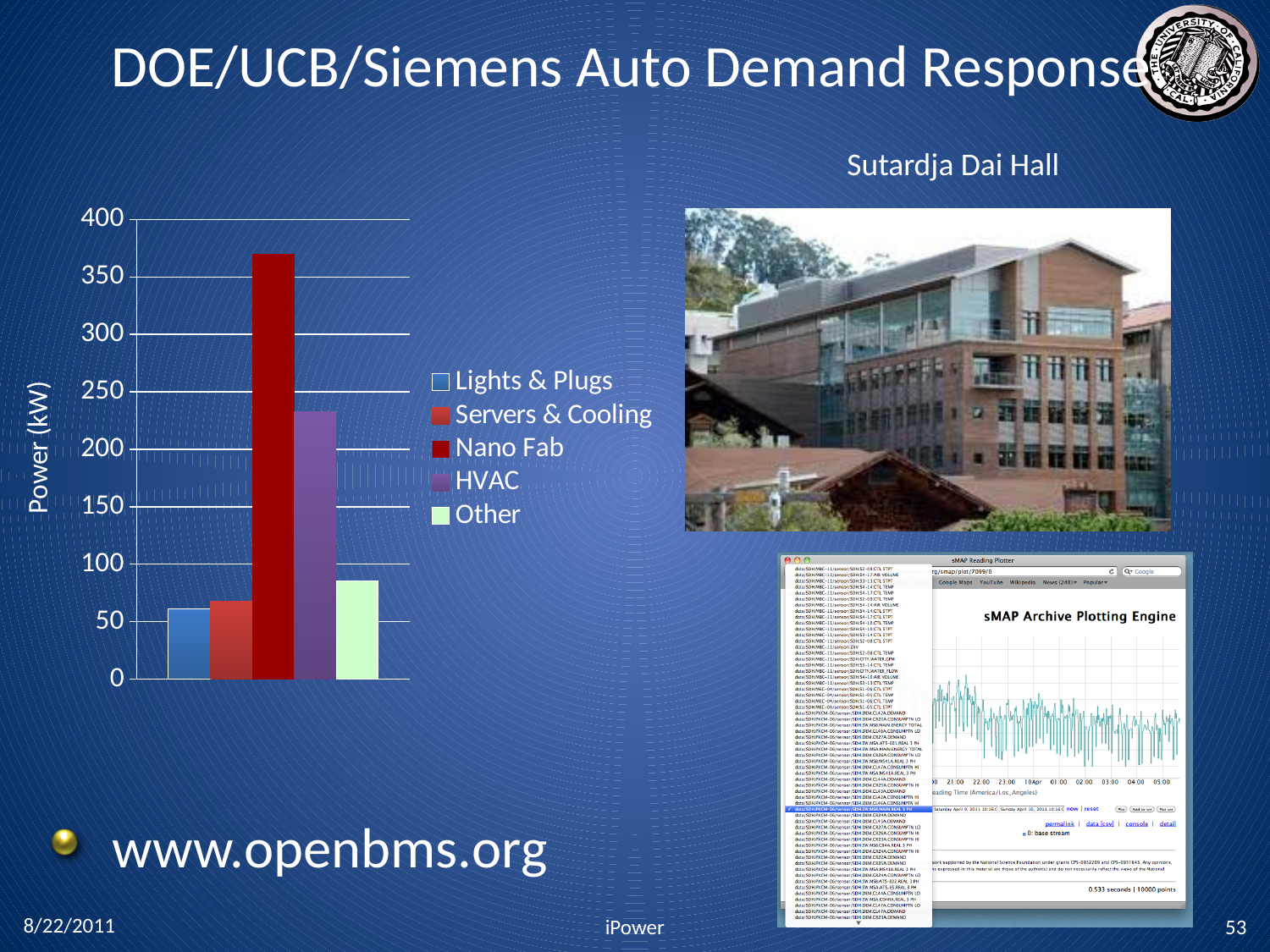
How many series does the chart's legend list? 5 Is the value for Nano Fab greater or less than 350? greater What kind of chart is shown on the slide? bar chart Which series has the highest power value in the chart? Nano Fab Which is larger, the value for HVAC or the value for Other? HVAC Is the value for Other greater or less than 100? less What is the label on the vertical axis of the chart? Power (kW) Which is larger, the value for Nano Fab or the value for HVAC? Nano Fab What colour is the Nano Fab bar in the chart? dark red Is the value for HVAC greater or less than 200? greater